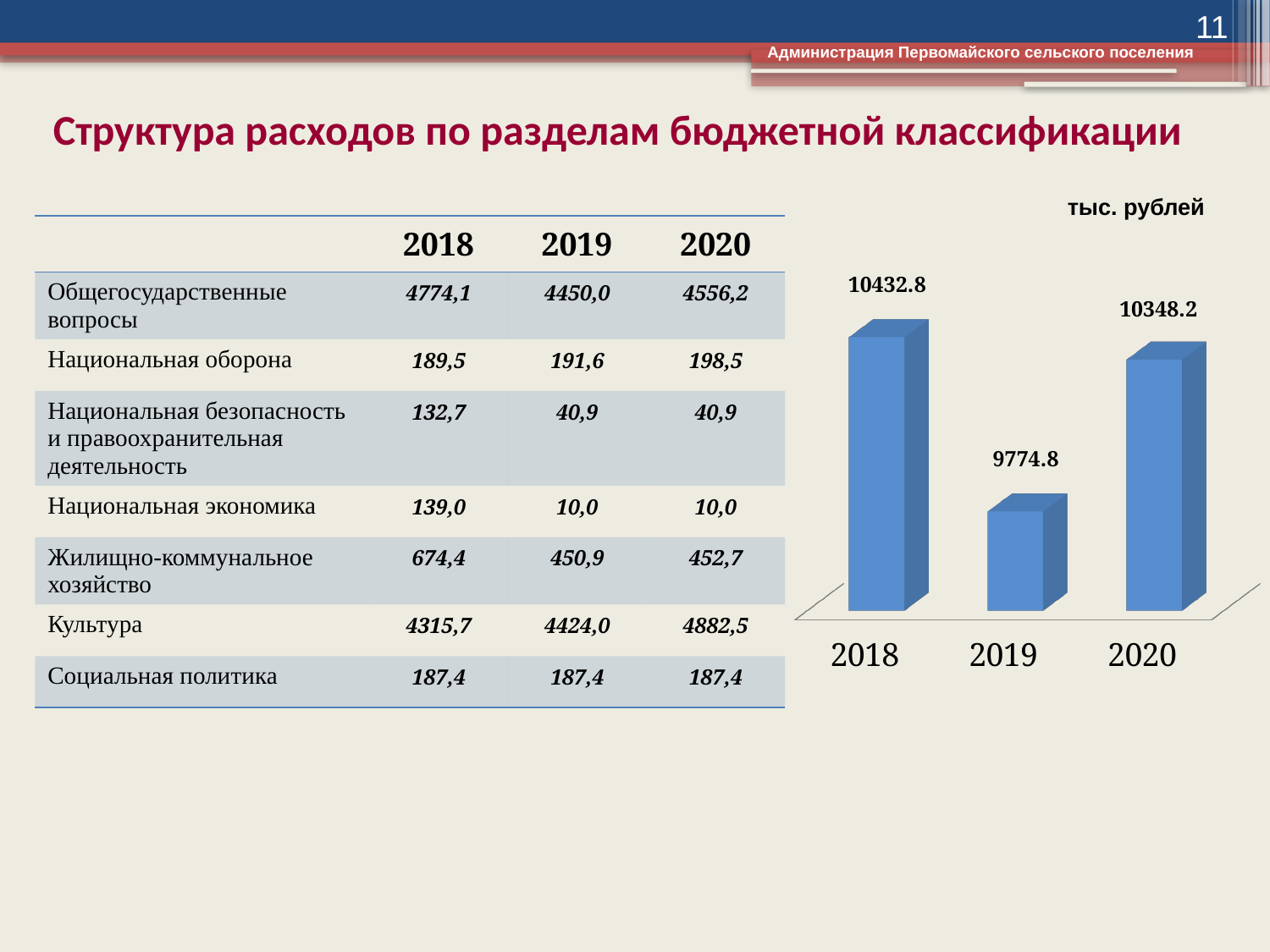
In the bar chart, does the value rise or fall from 2018 to 2019? Fall Which year has the lowest value in the bar chart? 2019 Which year has the highest value in the bar chart? 2018 What unit is indicated above the bar chart? тыс. рублей What type of chart is shown on the slide? Bar chart In the bar chart, which is larger: the value for 2018 or the value for 2020? 2018 In the bar chart, what is the difference between the values for 2018 and 2019? 658.0 In the bar chart, what is the difference between the values for 2020 and 2019? 573.4 How many bars are plotted in the chart? 3 What is the value shown for 2019 in the bar chart? 9774.8 What is the value shown for 2020 in the bar chart? 10348.2 What is the value shown for 2018 in the bar chart? 10432.8